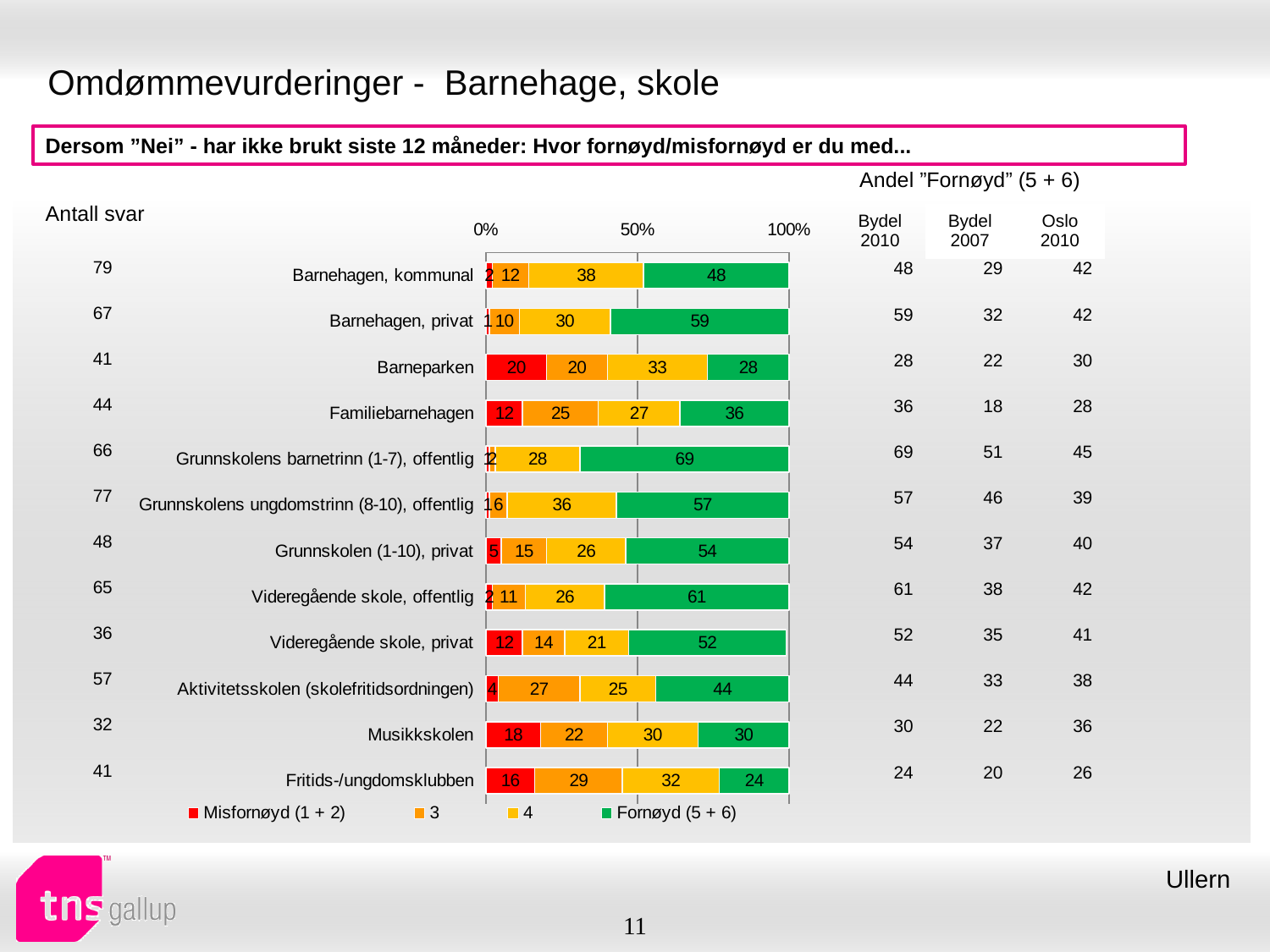
What is the Misfornøyd (1 + 2) value for Barneparken? 20 What is the difference between the Fornøyd (5 + 6) values for Barnehagen, privat and Barnehagen, kommunal? 11 What is the total of the stacked bar for Musikkskolen? 100 How many series does the chart legend list? 4 Which has a larger Fornøyd (5 + 6) value: Videregående skole, offentlig or Videregående skole, privat? Videregående skole, offentlig Which category has the lowest Fornøyd (5 + 6) value? Fritids-/ungdomsklubben What are the four legend entries of the chart? Misfornøyd (1 + 2), 3, 4, Fornøyd (5 + 6) What is the value of the '3' series for Fritids-/ungdomsklubben? 29 How many categories (services) are plotted in the chart? 12 What kind of chart is shown on the slide? Stacked bar chart What is the Fornøyd (5 + 6) value for Barnehagen, privat? 59 Which category has the highest Fornøyd (5 + 6) value? Grunnskolens barnetrinn (1-7), offentlig